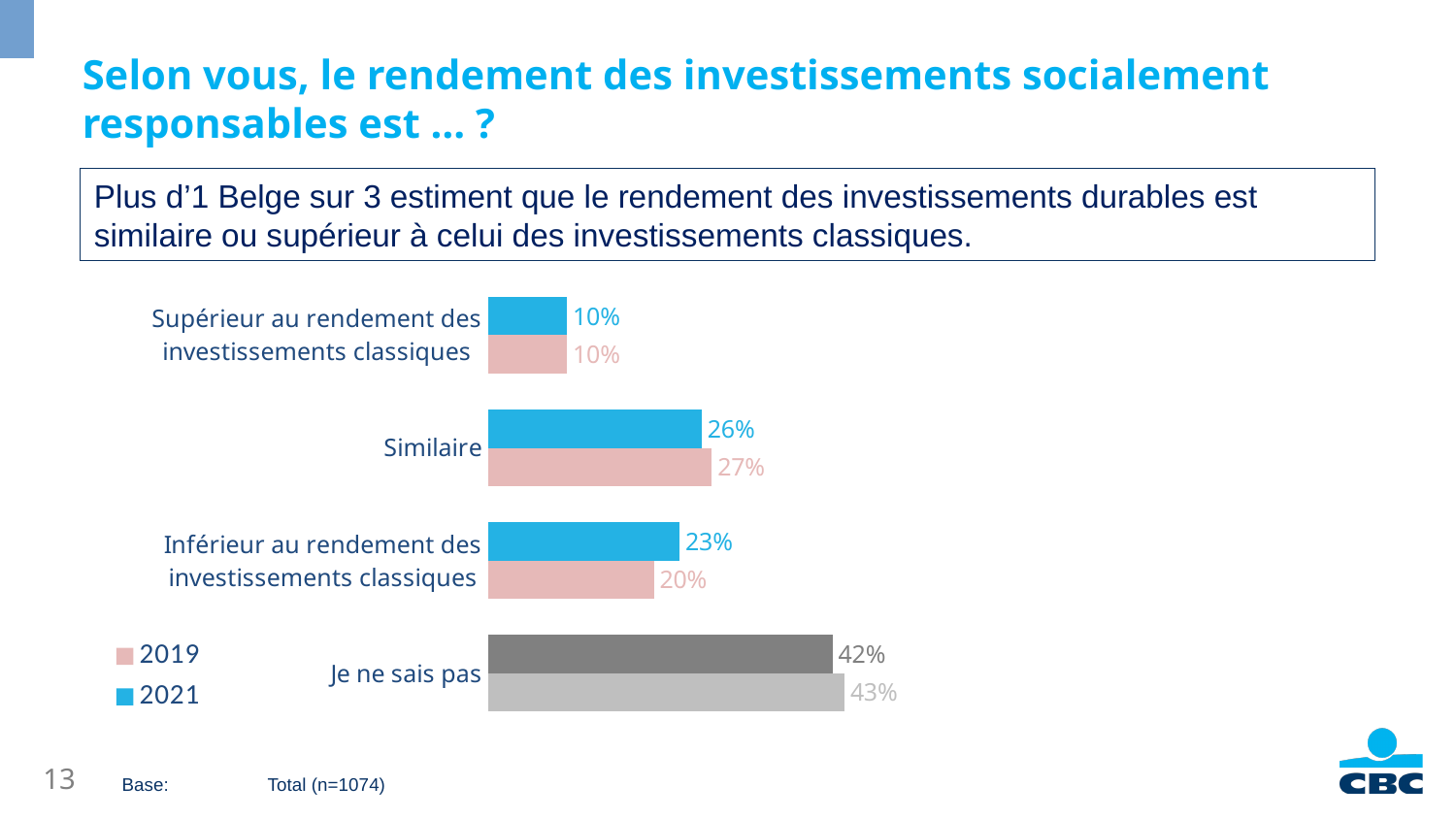
Which category has the highest 2021 value? Je ne sais pas What is the 2019 value for 'Je ne sais pas'? 43% How many series does the legend list? 2 What is the 2019 value for 'Similaire'? 27% What is the 2021 value for 'Similaire'? 26% Which category has the lowest 2019 value? Supérieur au rendement des investissements classiques How many categories are shown in the chart? 4 For 'Similaire', which year has the larger value, 2019 or 2021? 2019 What kind of chart is shown on the slide? bar chart What is the difference between the 2021 and 2019 values for 'Inférieur au rendement des investissements classiques'? 3% What is the 2021 value for 'Inférieur au rendement des investissements classiques'? 23% Which years are listed in the legend? 2019 and 2021